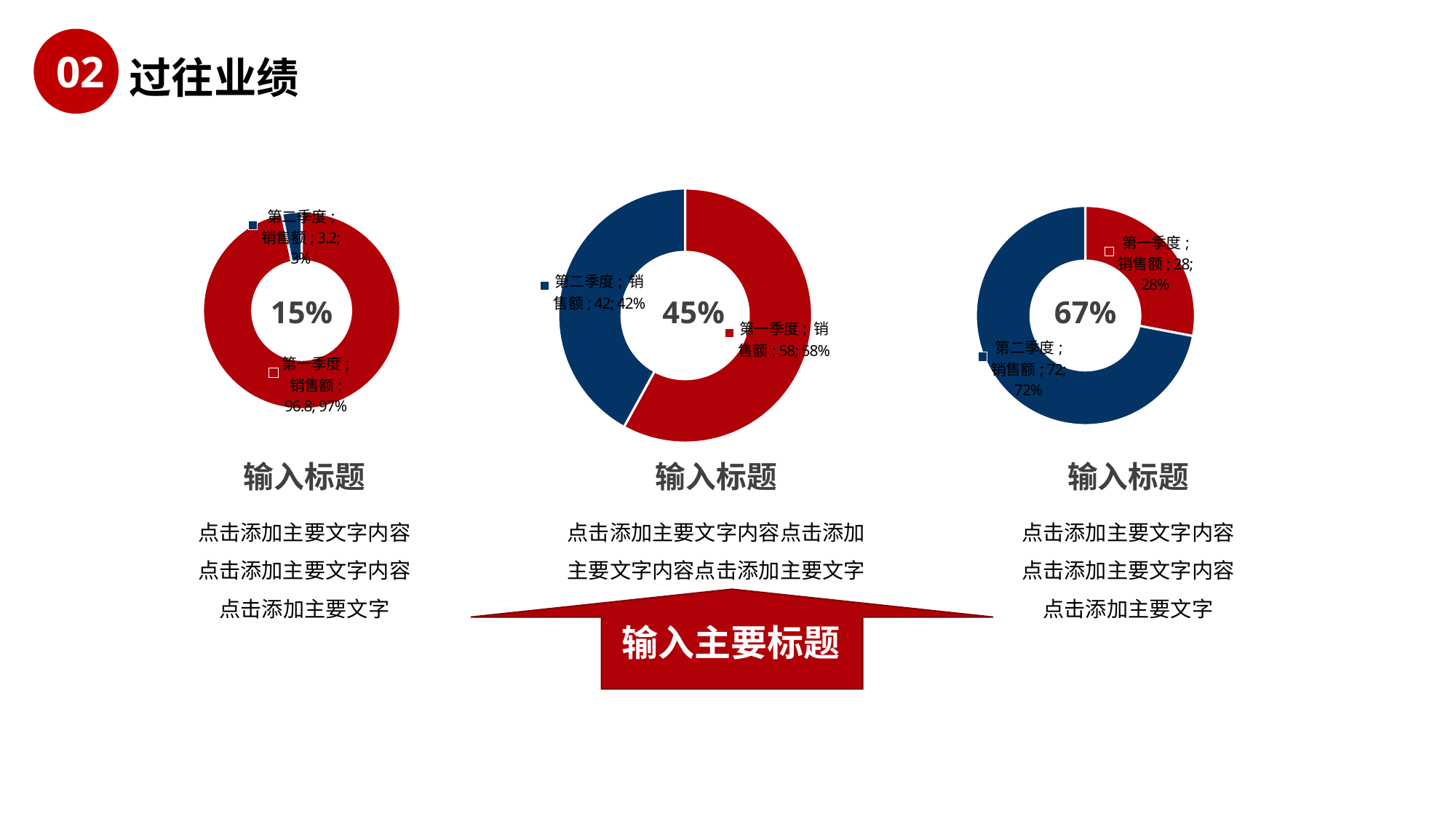
What type of chart is used for each of the three charts on the slide? Doughnut (pie) chart In the middle doughnut chart, what is the difference between the 第一季度 and 第二季度 销售额 values? 16 In the right doughnut chart, what percentage share does 第一季度 have? 28% In the middle doughnut chart, what is the 销售额 value for 第一季度? 58 In the left doughnut chart, what is the 销售额 value for 第一季度? 96.8 In the right doughnut chart, which quarter has the smaller slice? 第一季度 In the right doughnut chart, is the 销售额 for 第二季度 larger or smaller than that for 第一季度? larger In the right doughnut chart, what is the 销售额 value for 第二季度? 72 In the middle doughnut chart, what percentage share does 第二季度 have? 42% In the left doughnut chart, which quarter has the larger slice? 第一季度 How many slices does the middle doughnut chart have? 2 In the left doughnut chart, what is the 销售额 value for 第二季度? 3.2